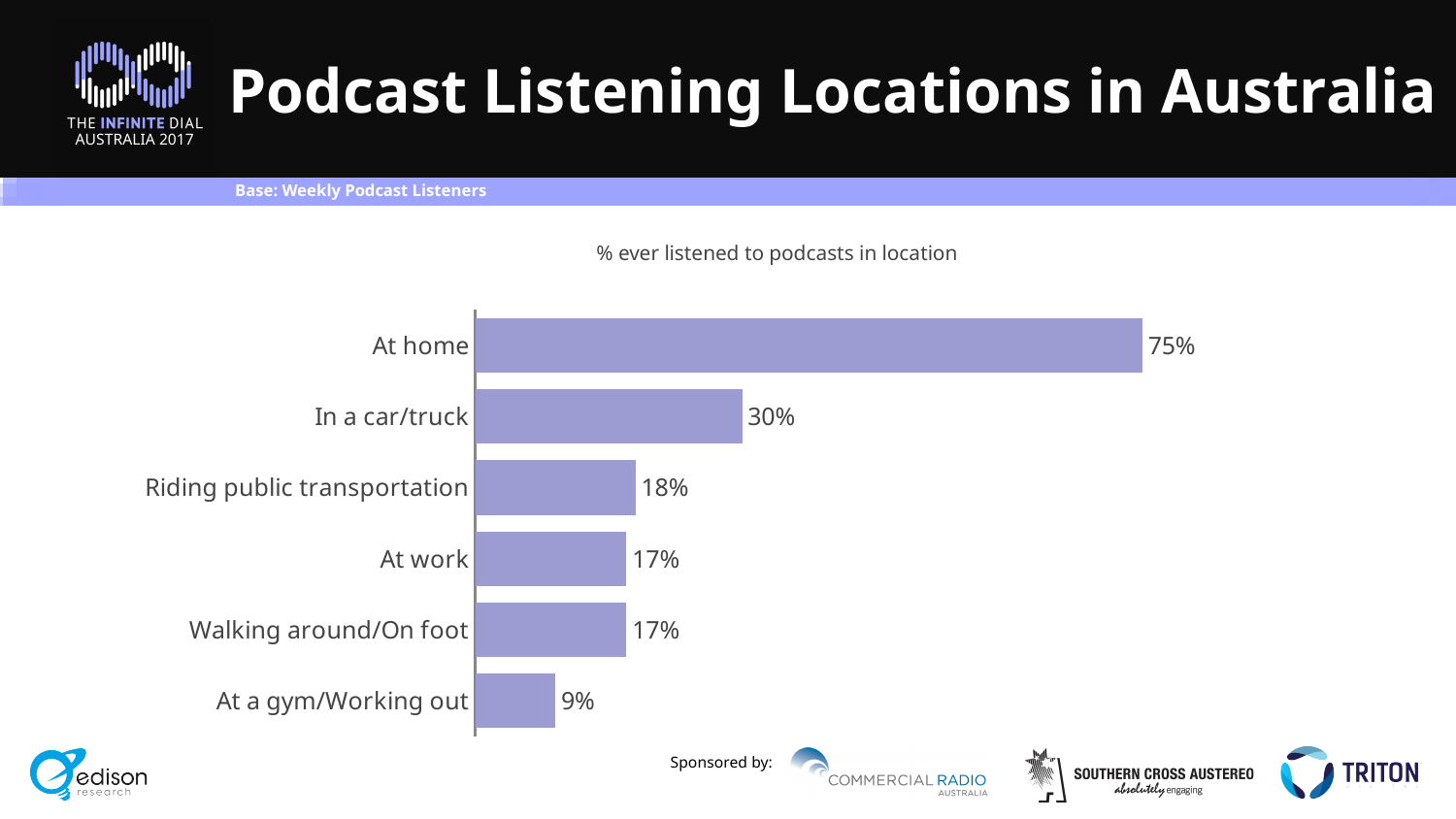
Which is larger: the value for 'In a car/truck' or for 'At work'? In a car/truck Which location has the highest percentage? At home What percentage is shown for 'Riding public transportation'? 18% What is the value for 'At a gym/Working out'? 9% How many locations are shown in the chart? 6 What is the difference between 'Riding public transportation' and 'At a gym/Working out'? 9% What is the subtitle shown above the chart? % ever listened to podcasts in location What is the value for 'In a car/truck'? 30% What percentage of weekly podcast listeners have ever listened to podcasts at home? 75% What is the difference between the 'At home' and 'In a car/truck' values? 45% What kind of chart is shown on the slide? Bar chart Which location has the lowest percentage? At a gym/Working out